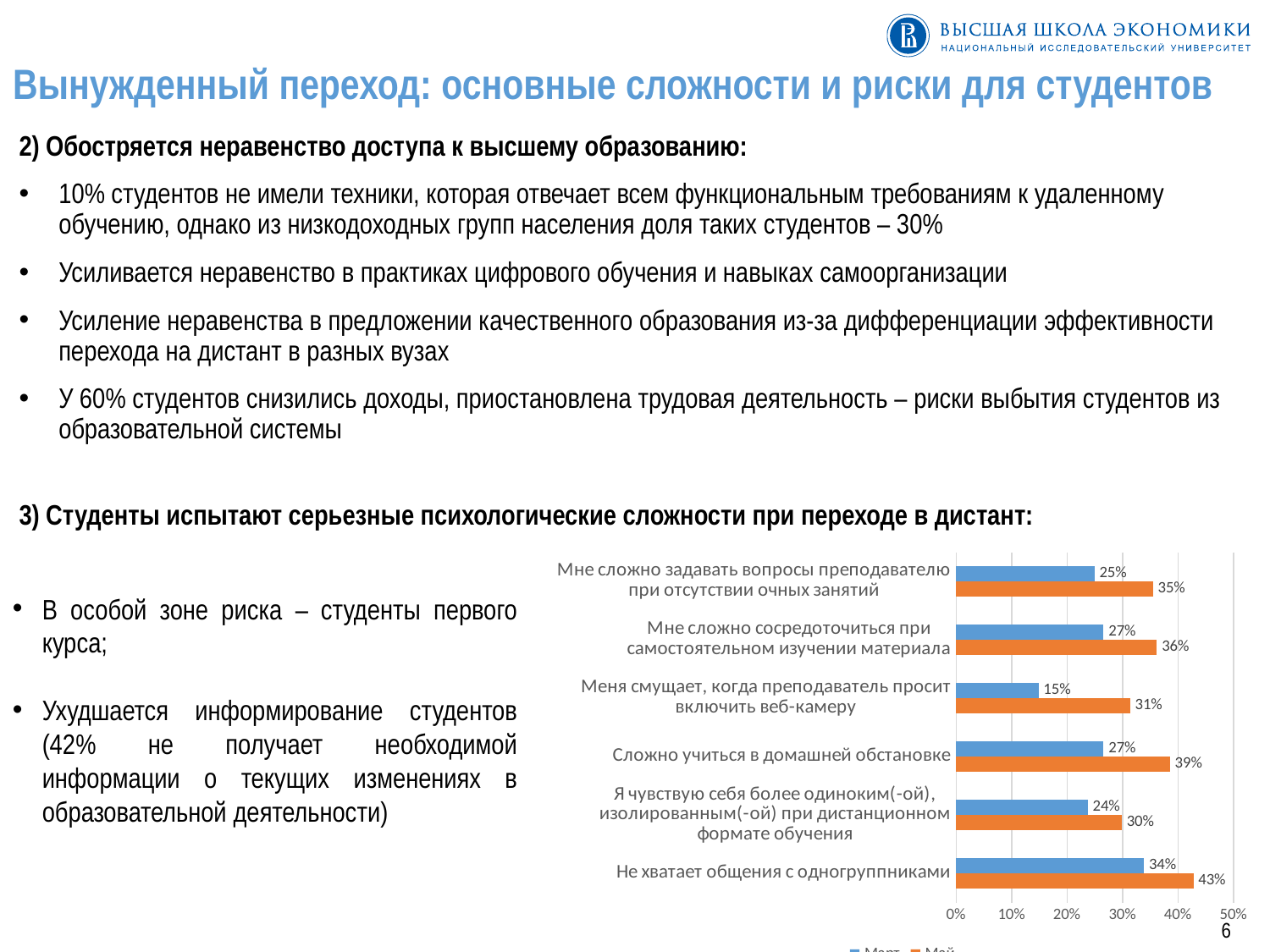
What is the value of the blue bar for "Меня смущает, когда преподаватель просит включить веб-камеру"? 15% What is the value of the orange bar for "Не хватает общения с одногруппниками"? 43% Which category has the lowest value among the blue bars? Меня смущает, когда преподаватель просит включить веб-камеру What is the difference between the orange and blue bars for "Меня смущает, когда преподаватель просит включить веб-камеру"? 16% What is the value of the orange bar for "Сложно учиться в домашней обстановке"? 39% Is the blue bar for "Не хватает общения с одногруппниками" greater or less than 30%? greater Which is larger for "Мне сложно сосредоточиться при самостоятельном изучении материала": the blue bar or the orange bar? the orange bar Which category has the highest value among the orange bars? Не хватает общения с одногруппниками How many series does the chart show? 2 How many categories are plotted in the chart? 6 What is the value of the blue bar for "Я чувствую себя более одиноким(-ой), изолированным(-ой) при дистанционном формате обучения"? 24% What type of chart is shown on the slide? bar chart